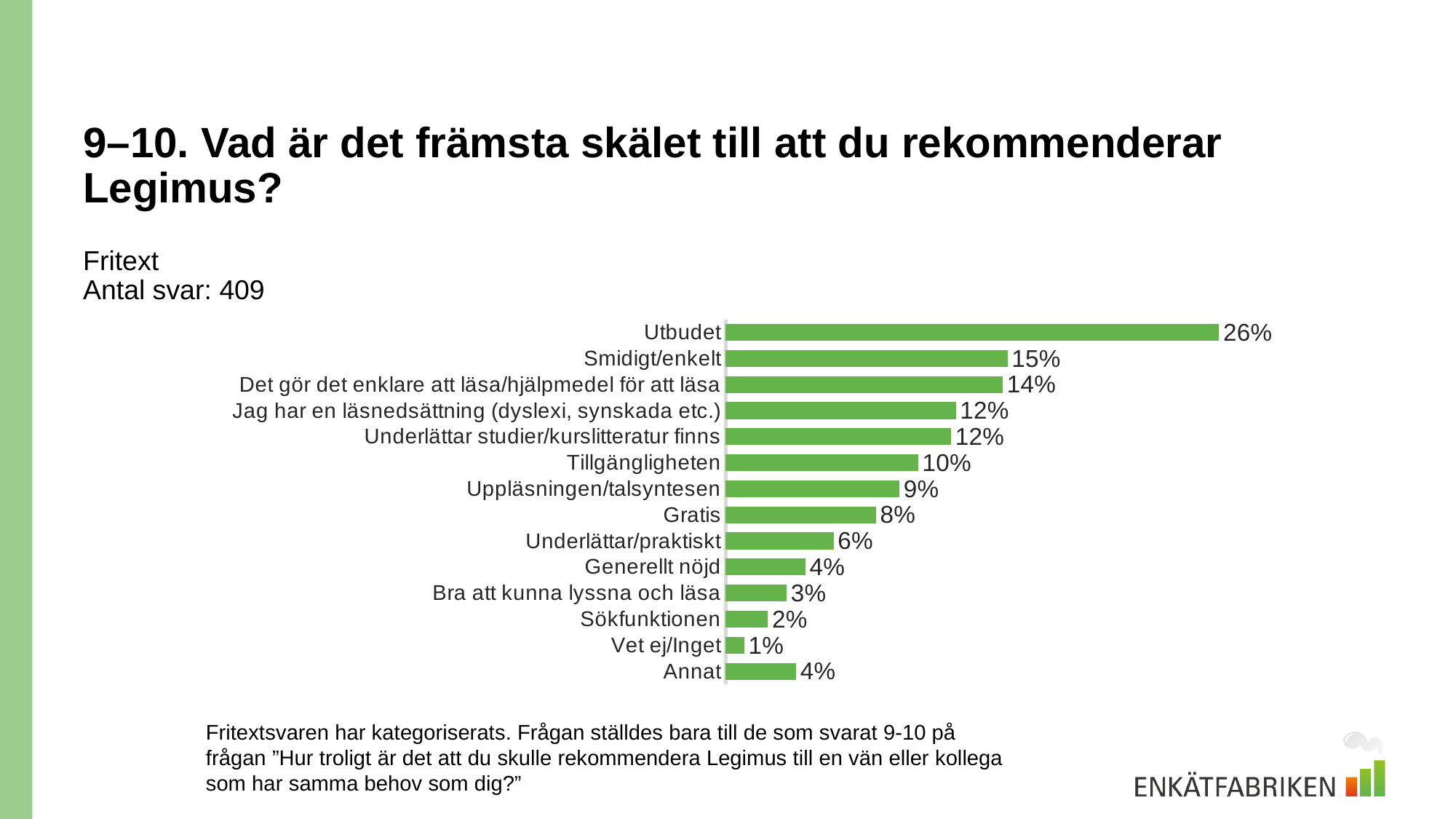
Which category has the highest value? Utbudet What is the value for Gratis? 8% What is the difference between the values for Generellt nöjd and Bra att kunna lyssna och läsa? 1 percentage point Which is larger, the value for Uppläsningen/talsyntesen or the value for Underlättar/praktiskt? Uppläsningen/talsyntesen What kind of chart is shown on the slide? Bar chart What is the value for Utbudet? 26% What is the difference between the values for Utbudet and Smidigt/enkelt? 11 percentage points Which category has the lowest value? Vet ej/Inget How many responses (Antal svar) does the slide report for this question? 409 What is the value for Tillgängligheten? 10% What is the value for Sökfunktionen? 2% How many categories are shown in the chart? 14